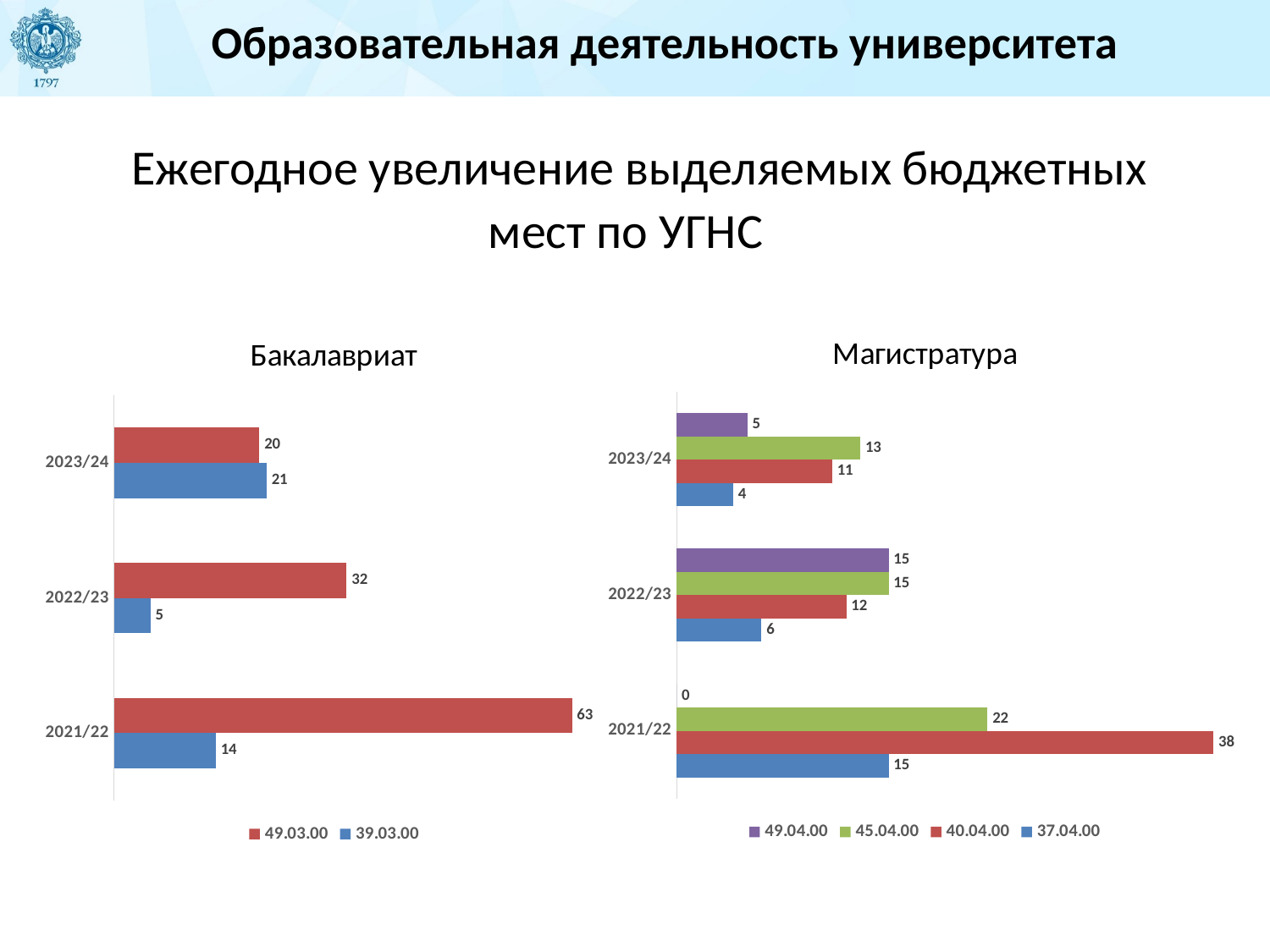
In the Бакалавриат chart, what is the difference between 49.03.00 and 39.03.00 in 2022/23? 27 In the Магистратура chart, which is larger in 2022/23: 40.04.00 or 37.04.00? 40.04.00 In the Магистратура chart, which series has the lowest value in 2023/24? 37.04.00 In the Магистратура chart, how many year categories are shown? 3 In the Бакалавриат chart, how many series does the legend list? 2 What type of chart is the Бакалавриат chart? Bar chart In the Бакалавриат chart, what is the value for 39.03.00 in 2022/23? 5 In the Бакалавриат chart, what is the value for 49.03.00 in 2021/22? 63 In the Магистратура chart, how many series does the legend list? 4 In the Магистратура chart, what is the value for 49.04.00 in 2021/22? 0 In the Бакалавриат chart, which year has the highest value for 49.03.00? 2021/22 In the Магистратура chart, what is the value for 40.04.00 in 2021/22? 38